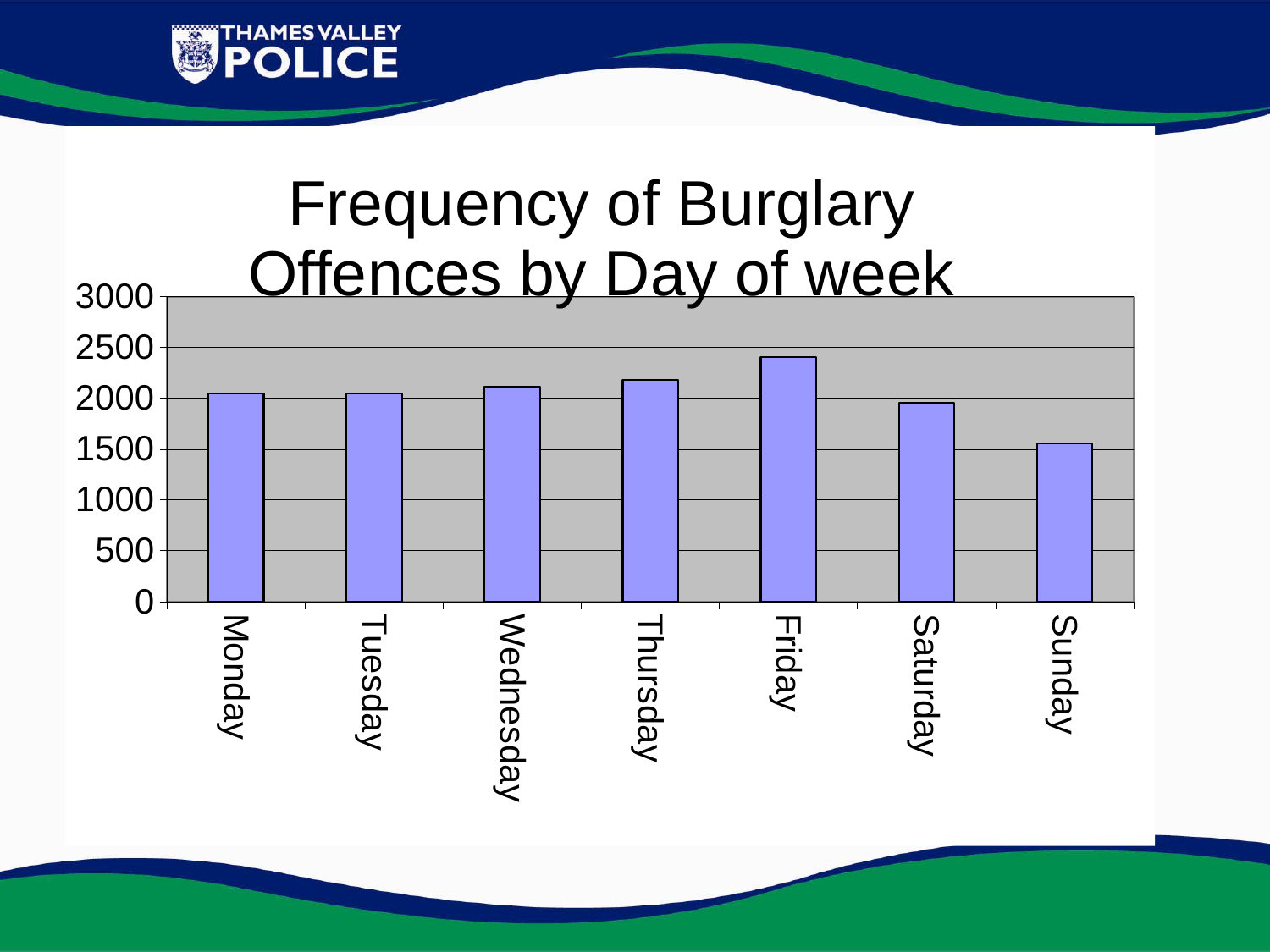
Do the values rise or fall from Friday to Sunday? fall How many days of the week are plotted on the chart? 7 What kind of chart is shown on the slide? bar chart Is the value for Sunday greater or less than 2000? less Is the value for Friday greater or less than 2000? greater What is the title of the chart? Frequency of Burglary Offences by Day of week Which is larger, the value for Thursday or the value for Saturday? Thursday Which day of the week has the highest frequency of burglary offences? Friday Which is larger, the value for Friday or the value for Sunday? Friday Which day of the week has the lowest frequency of burglary offences? Sunday Is the value for Thursday greater or less than 2500? less